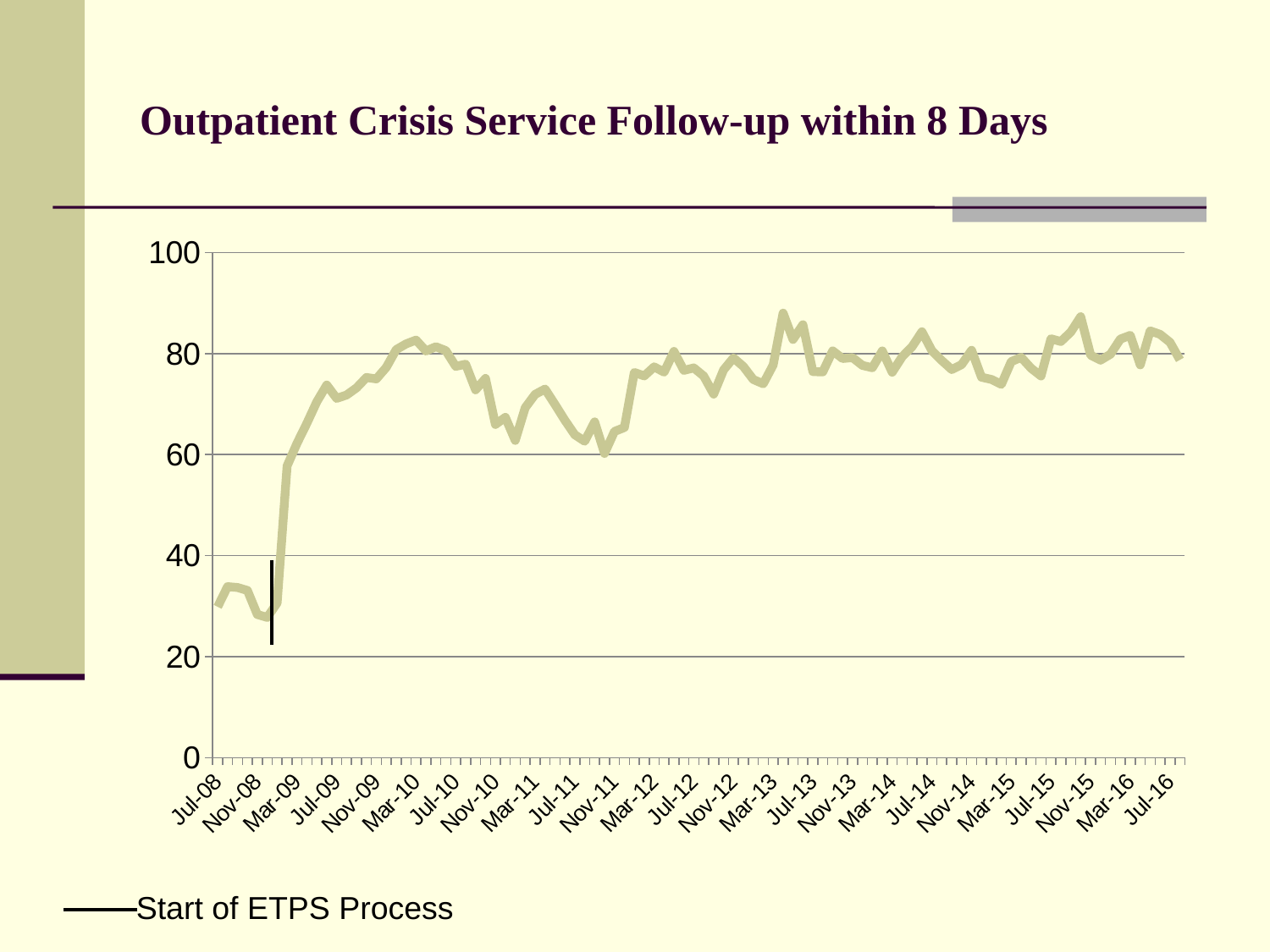
Overall, does the line rise or fall from Jul-08 to Jul-16? rise What does the legend entry below the chart say? Start of ETPS Process Is the value for Jul-09 greater or less than 60? greater Does the line rise or fall between Jul-08 and Jul-09? rise Is the value for Nov-08 greater or less than 40? less Is the value for Jul-08 greater or less than 40? less What is the title of the chart? Outpatient Crisis Service Follow-up within 8 Days What kind of chart is shown on the slide? line chart Is the value for Jul-08 larger or smaller than the value for Jul-16? smaller